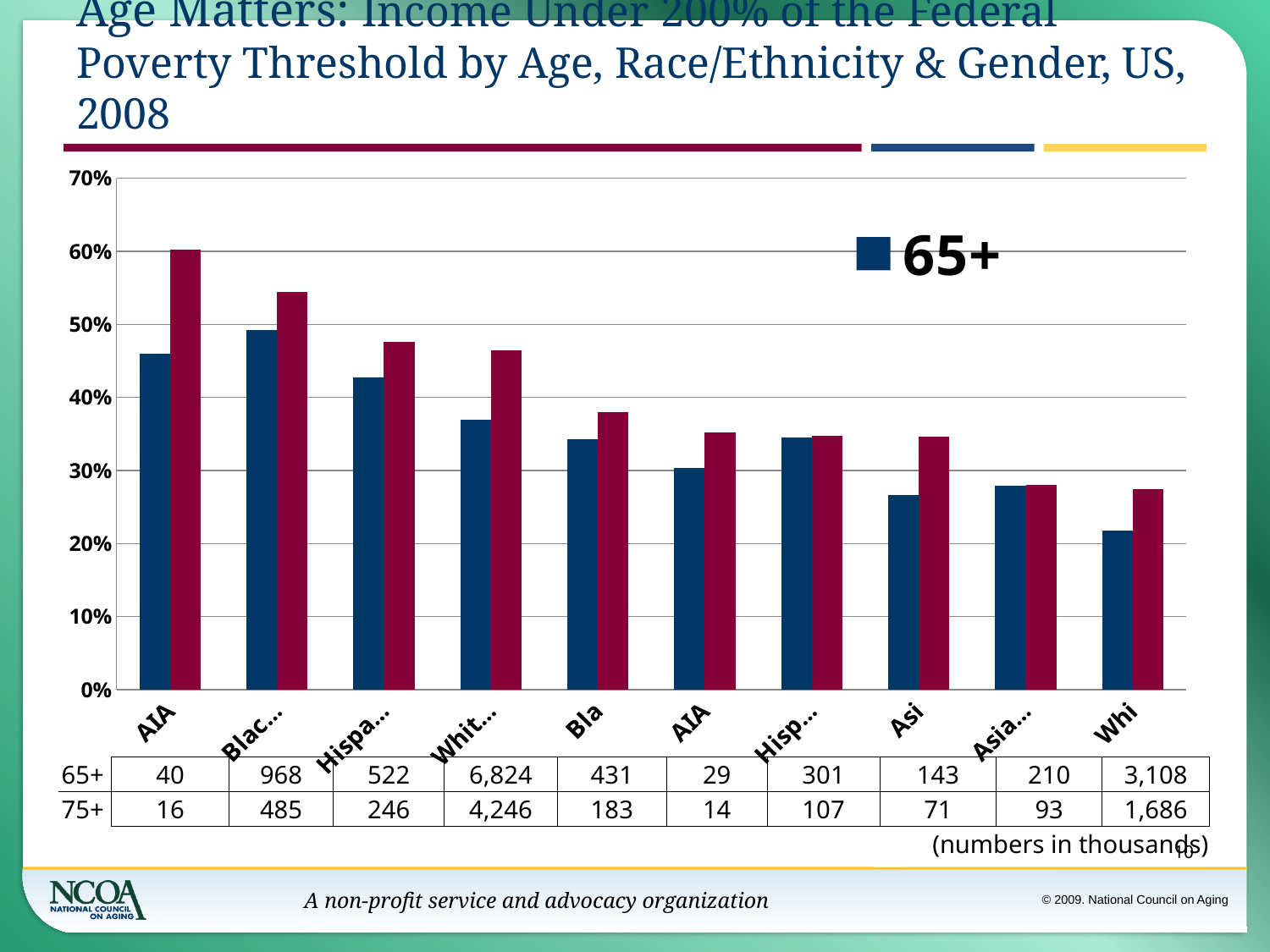
In the data table below the chart, what is the 75+ value for the last category (Whi)? 1,686 Which age group is listed in the chart's legend? 65+ Which category has the tallest 75+ bar? AIA (the first category) In the data table, what is the difference between the 65+ and 75+ values for the fourth category (Whit...)? 2,578 Is the 65+ bar for the first category (AIA) greater or less than 40%? greater In the data table below the chart, what is the 65+ value for the fourth category (Whit...)? 6,824 Is the 75+ bar for the first category (AIA) greater or less than 50%? greater What kind of chart is shown on the slide? bar chart Which category has the shortest 65+ bar? Whi (the last category) Is the 65+ bar for the last category (Whi) greater or less than 30%? less How many categories are shown along the x axis of the chart? 10 Do the bar heights generally rise or fall moving from left to right along the x axis? fall